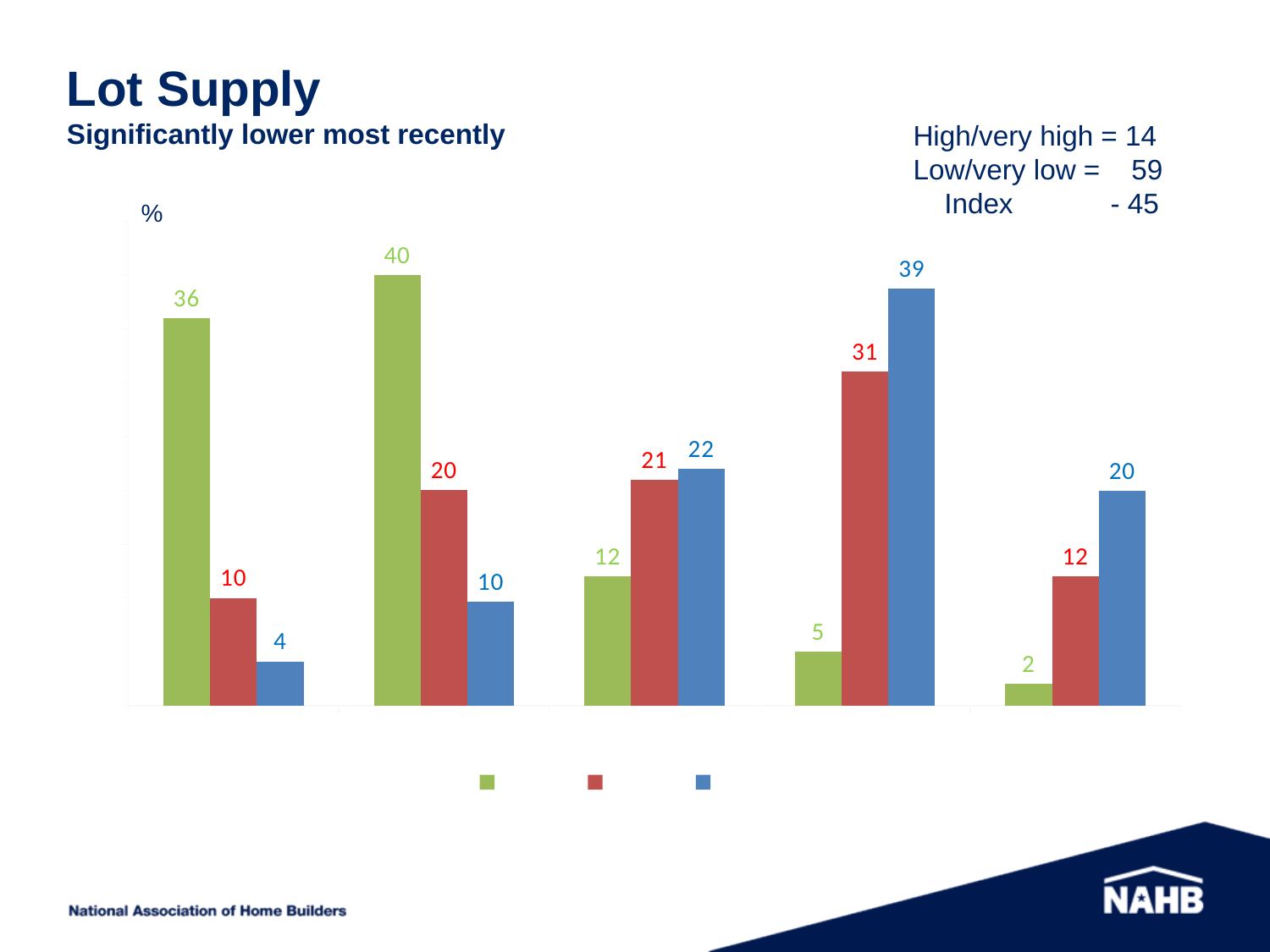
What is the value of the red bar in the second group from the left? 20 How many series does the legend show? 3 What type of chart is shown on the slide? bar chart Which group has the highest green bar? the second group from the left (40) In the fifth (rightmost) group, which is larger, the red bar or the blue bar? the blue bar (20) Which group has the lowest blue bar? the first (leftmost) group (4) What is the value of the green bar in the first (leftmost) group? 36 How many groups of bars are plotted along the x axis? 5 What is the difference between the blue bar and the green bar in the fourth group from the left? 34 What is the title of the chart on the slide? Lot Supply Do the green bar values rise or fall from the second group to the fifth group along the x axis? fall What is the value of the blue bar in the fourth group from the left? 39